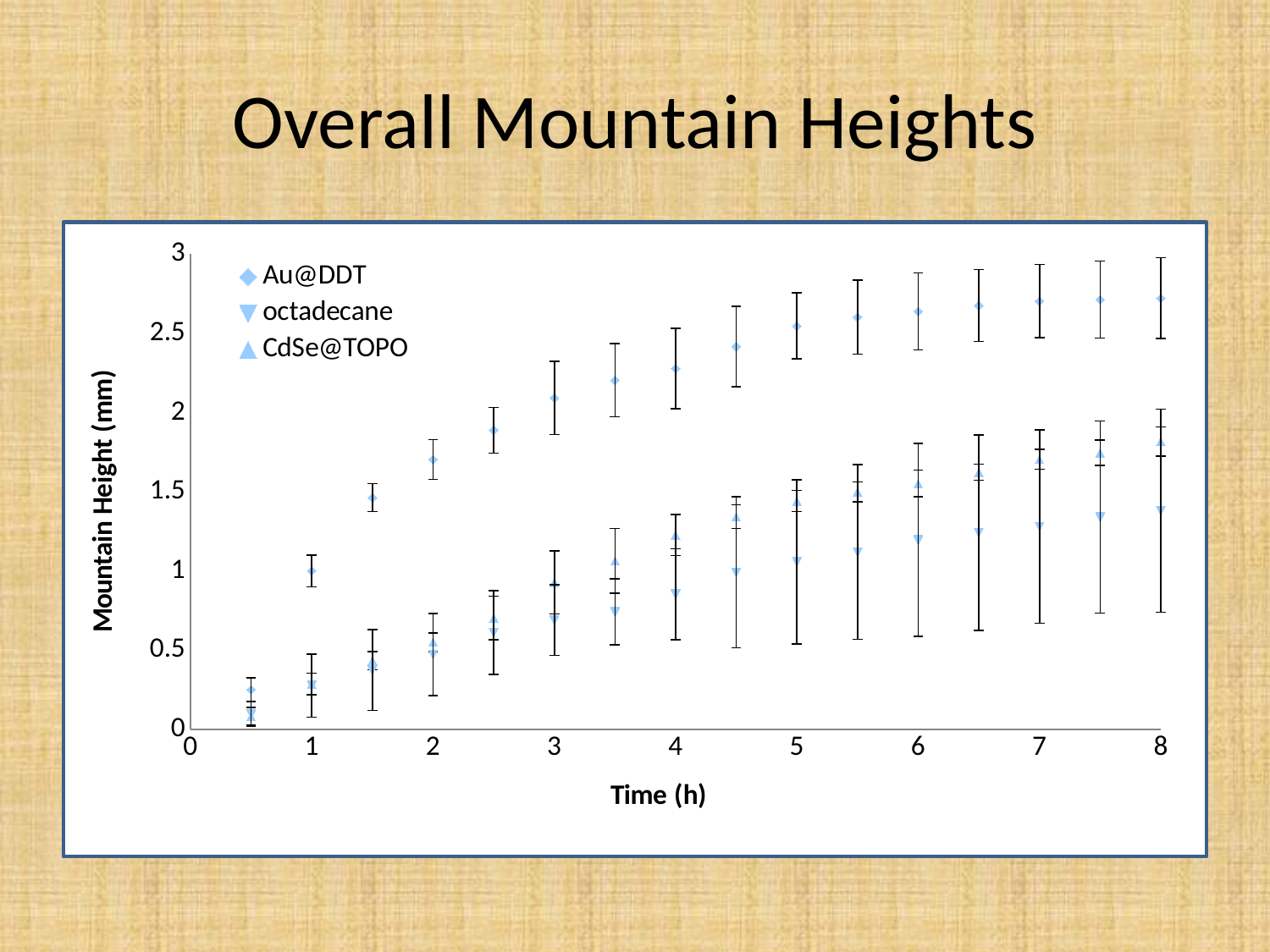
What is the title of the chart? Overall Mountain Heights Is the value for Au@DDT at 2 h greater or less than 1.5? greater How many series does the legend list? 3 Do the Au@DDT values rise or fall as time increases? rise Which series reaches the highest mountain height on the chart? Au@DDT Is the value for octadecane at 8 h greater or less than 1.5? less At 8 h, which series has the larger value, Au@DDT or octadecane? Au@DDT Is the value for Au@DDT at 0.5 h greater or less than 0.5? less At 6 h, which series has the larger value, CdSe@TOPO or octadecane? CdSe@TOPO What kind of chart is shown on the slide? scatter chart What is the label of the y axis? Mountain Height (mm)